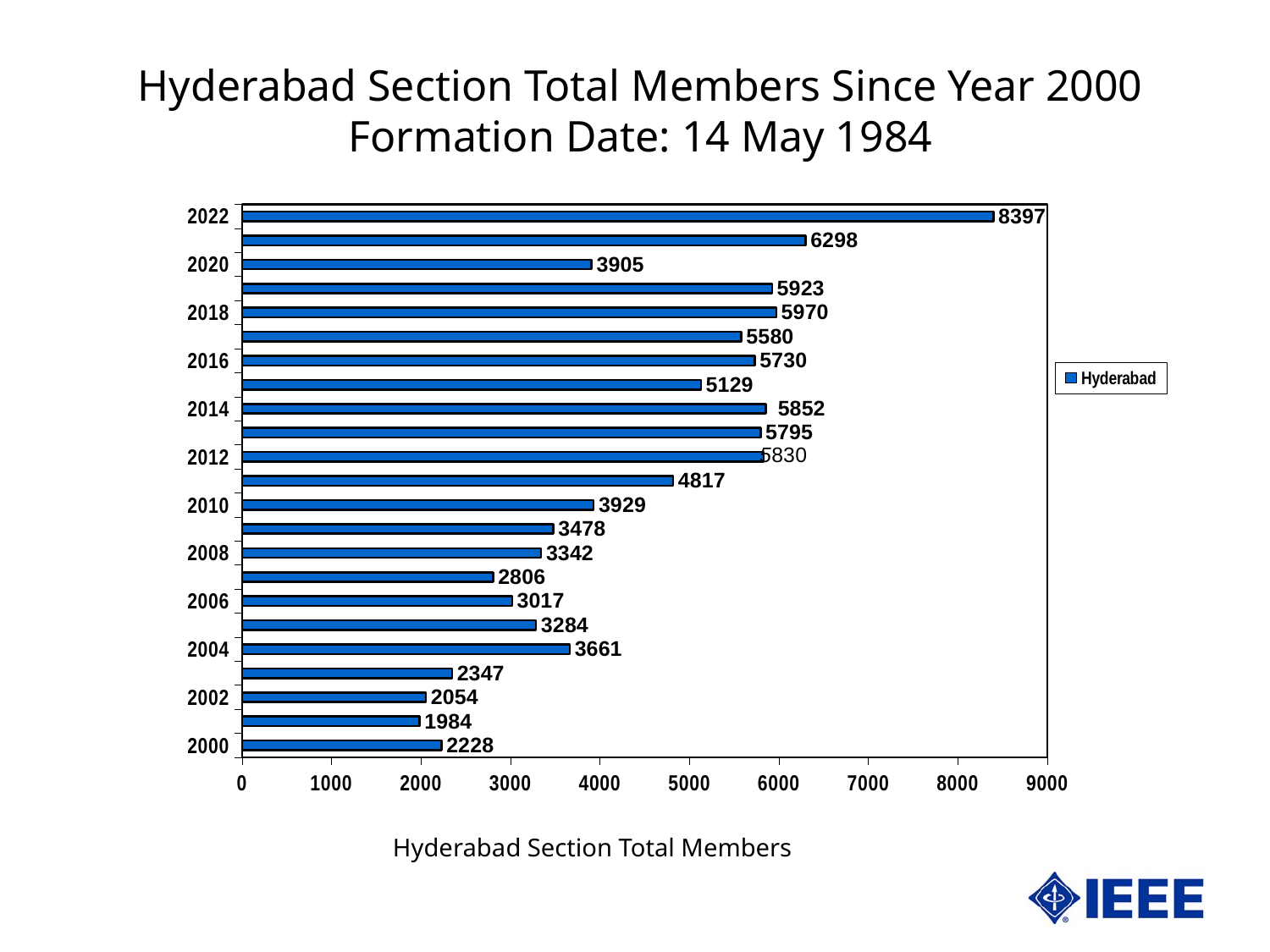
Which is larger, the value for 2018 or the value for 2016? 2018 What is the single entry listed in the legend? Hyderabad What is the difference between the values for 2010 and 2000? 1701 What is the difference between the values for 2022 and 2020? 4492 Which is larger, the value for 2004 or the value for 2002? 2004 What is the value for 2000? 2228 What is the value for 2010? 3929 Which year has the highest number of members? 2022 What is the value for 2022? 8397 How many bars are plotted in the chart? 23 What kind of chart is shown on the slide? bar chart What is the value for 2020? 3905